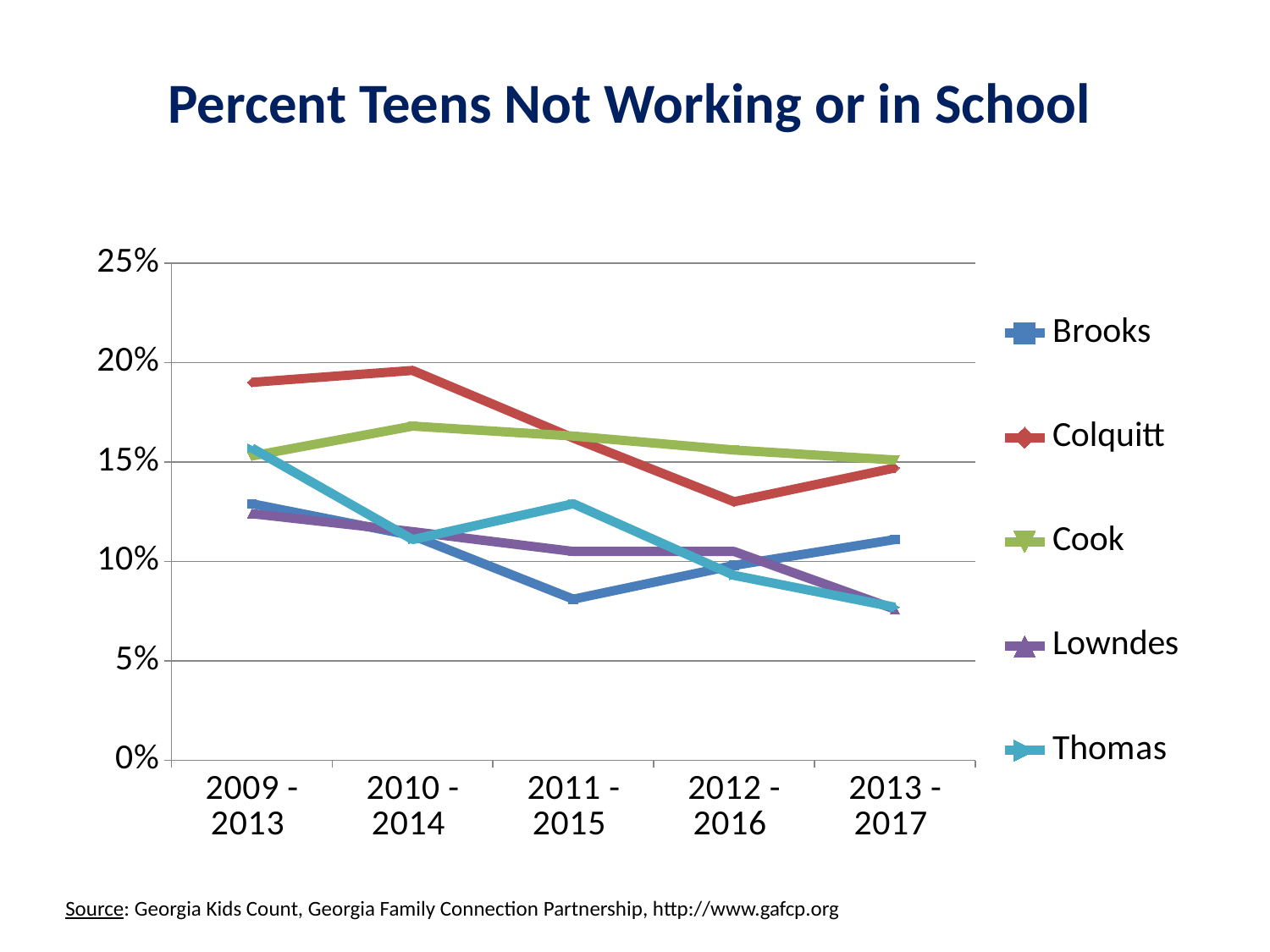
Does the value for Lowndes rise or fall from 2009 - 2013 to 2013 - 2017? fall Which county has the highest value in 2009 - 2013? Colquitt What is the title of the chart? Percent Teens Not Working or in School In 2012 - 2016, which is larger, the value for Cook or the value for Colquitt? Cook In 2013 - 2017, which is larger, the value for Brooks or the value for Lowndes? Brooks Is the value for Colquitt in 2010 - 2014 greater or less than 15%? greater Is the value for Brooks in 2011 - 2015 greater or less than 10%? less How many time periods are shown on the x axis? 5 What kind of chart is shown on the slide? line chart Which county has the lowest value in 2011 - 2015? Brooks How many series does the legend list? 5 Is the value for Thomas in 2013 - 2017 greater or less than 10%? less